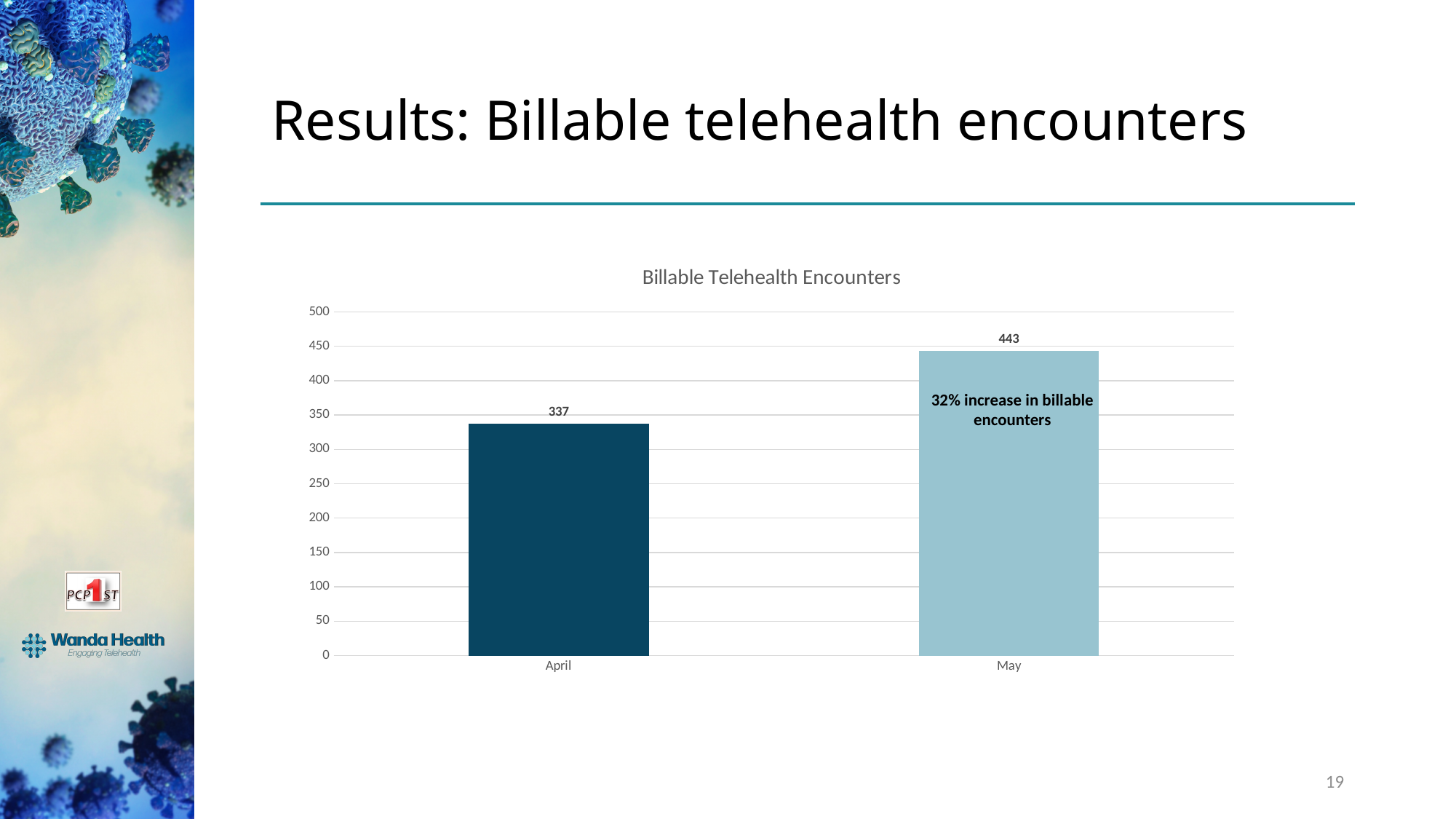
What is the difference between the values for May and April? 106 Is the value for April greater or less than 350? less Is the value for May greater or less than 400? greater Do the values rise or fall from April to May? rise How many categories are shown on the x axis? 2 What is the value for May? 443 What kind of chart is shown on the slide? bar chart Which month has the lowest number of billable telehealth encounters? April Which is larger, the value for April or the value for May? May What is the value for April? 337 Which month has the highest number of billable telehealth encounters? May What is the title of the chart? Billable Telehealth Encounters